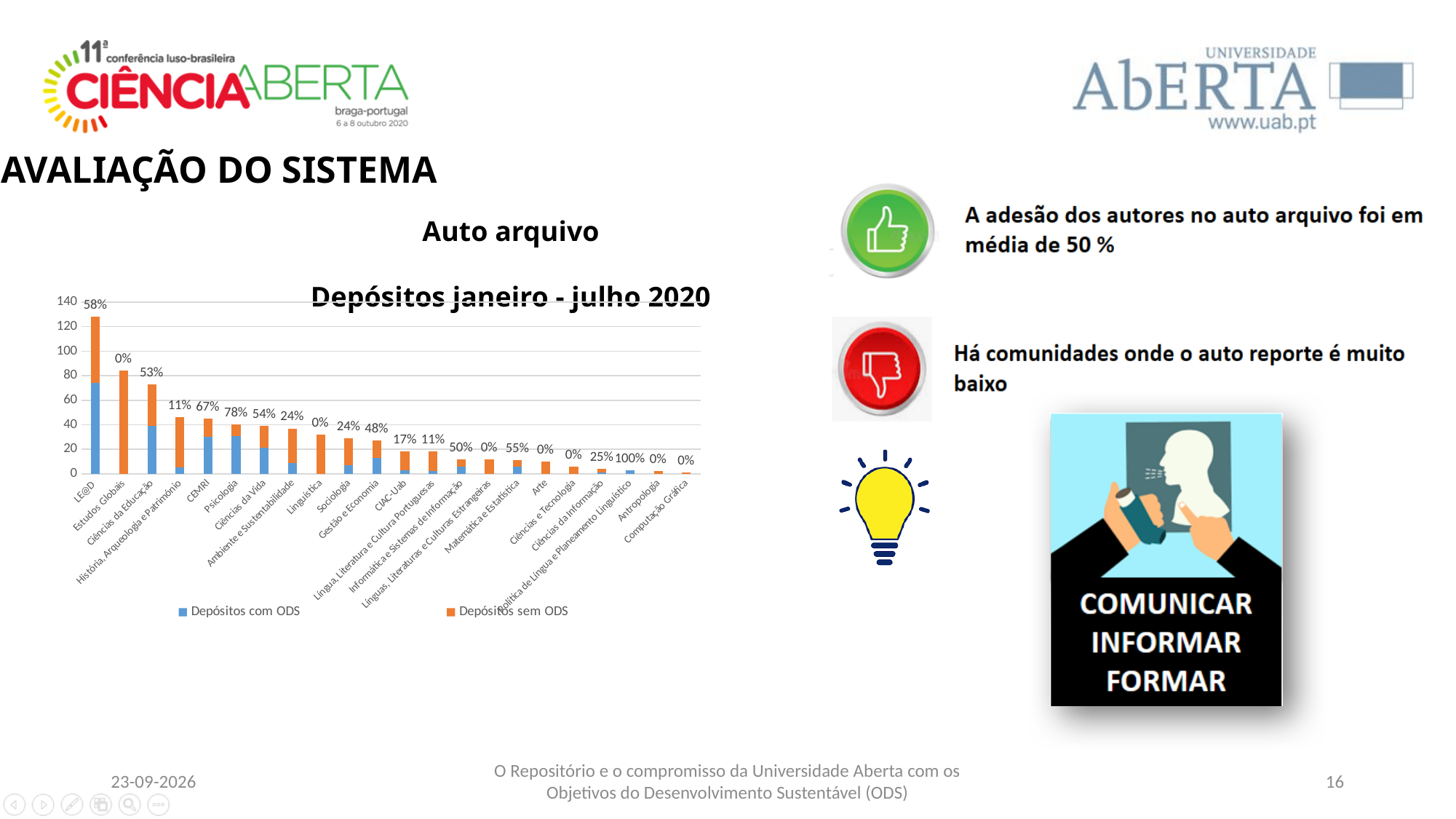
Is the total bar height for LE@D greater or less than 120? greater What percentage label is shown above the bar for Psicologia? 78% How many categories are plotted along the x axis of the chart? 22 Is the total bar height for Ciências da Educação greater or less than 60? greater Do the total bar heights rise or fall moving from left to right along the x axis? fall What are the two series named in the chart legend? Depósitos com ODS and Depósitos sem ODS What kind of chart is shown on the slide? bar chart What percentage label is shown above the bar for Estudos Globais? 0% Which has a taller total bar, Psicologia or Linguística? Psicologia How many series does the legend of the chart list? 2 Which category has the tallest bar in the chart? LE@D What percentage label is shown above the bar for Política de Língua e Planeamento Linguístico? 100%